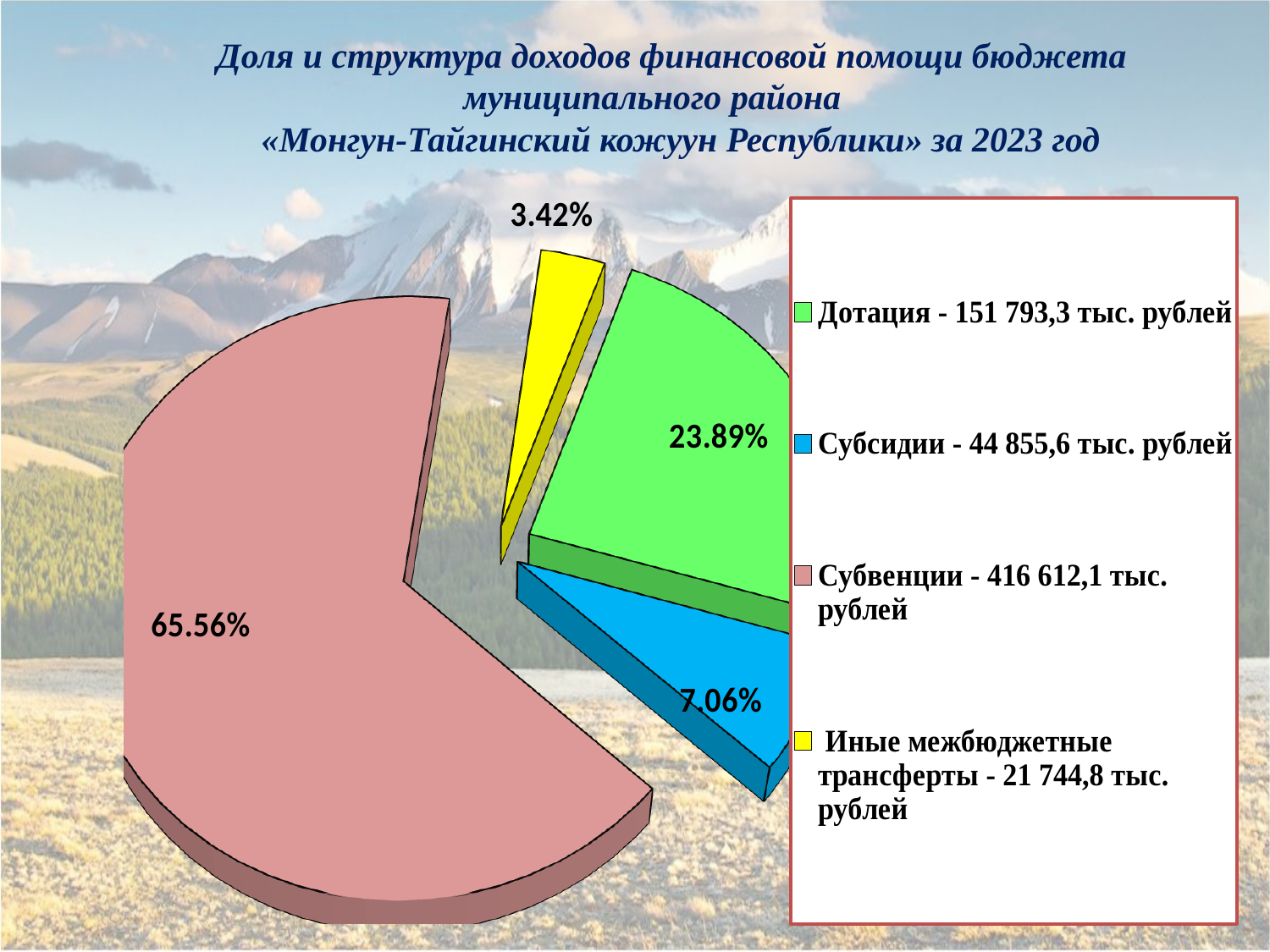
Which colour represents Субсидии in the pie chart? blue What share of the pie does Субсидии represent? 7.06% How many slices does the pie chart have? 4 What share of the pie does Субвенции represent? 65.56% Which category has the largest slice of the pie? Субвенции What is the difference in percentage points between the Субвенции slice and the Дотация slice? 41.67 What share of the pie does Дотация represent? 23.89% Which category has the smallest slice of the pie? Иные межбюджетные трансферты How many entries does the legend list? 4 What is the amount shown in the legend for Дотация? 151 793,3 тыс. рублей What type of chart is shown on the slide? pie chart